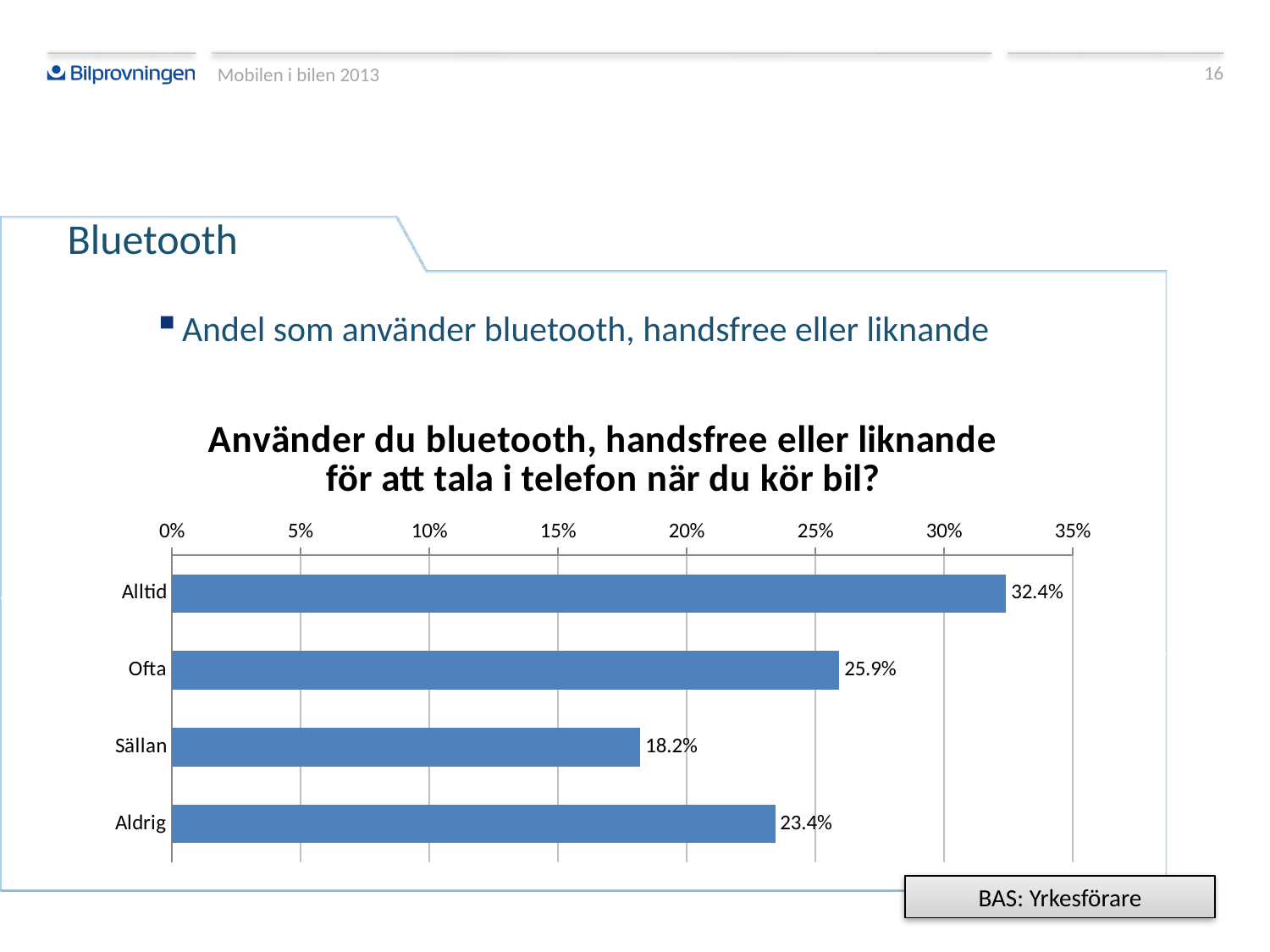
What kind of chart is shown on the slide? Bar chart Which category has the highest value? Alltid Which is larger, the value for Ofta or the value for Aldrig? Ofta What is the value for Alltid? 32.4% What is the difference between the values for Aldrig and Sällan? 5.2% What is the value for Ofta? 25.9% Which category has the lowest value? Sällan What is the value for Aldrig? 23.4% What is the difference between the values for Alltid and Ofta? 6.5% What is the value for Sällan? 18.2% How many categories are shown in the chart? 4 What is the title of the chart? Använder du bluetooth, handsfree eller liknande för att tala i telefon när du kör bil?